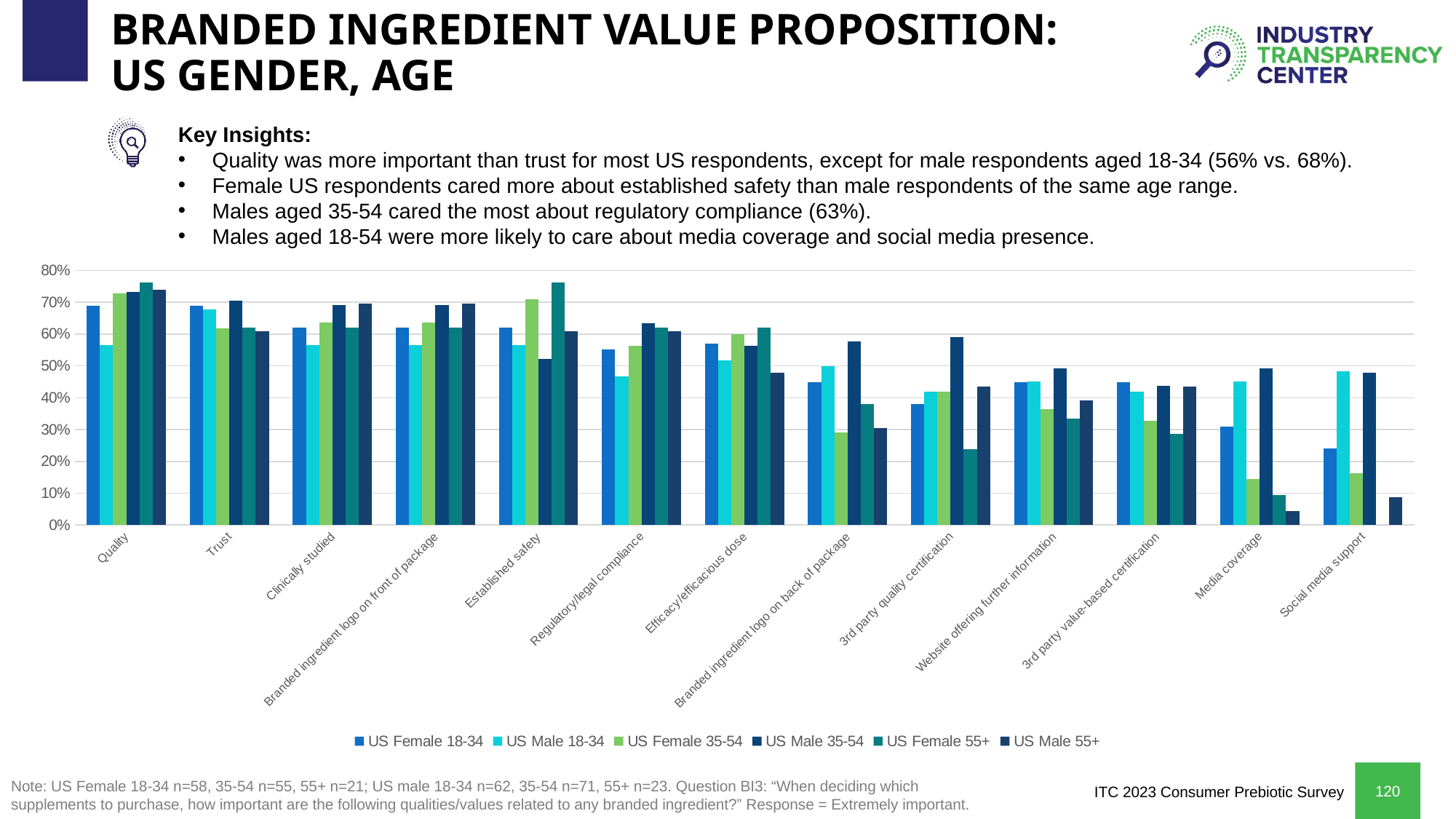
Is the value for US Male 35-54 in the 3rd party quality certification category greater or less than 50%? greater Is the value for US Female 35-54 in the Branded ingredient logo on back of package category greater or less than 40%? less Is the value for US Female 55+ in the Established safety category greater or less than 70%? greater How many series does the chart's legend list? 6 In the Quality category, which is larger: the value for US Female 55+ or the value for US Male 18-34? US Female 55+ In the Established safety category, which series has the highest value? US Female 55+ What kind of chart is shown on the slide? bar chart In the Media coverage category, which series has the lowest value? US Male 55+ How many categories are shown along the x axis of the chart? 13 In the Media coverage category, which is larger: the value for US Male 18-34 or the value for US Female 35-54? US Male 18-34